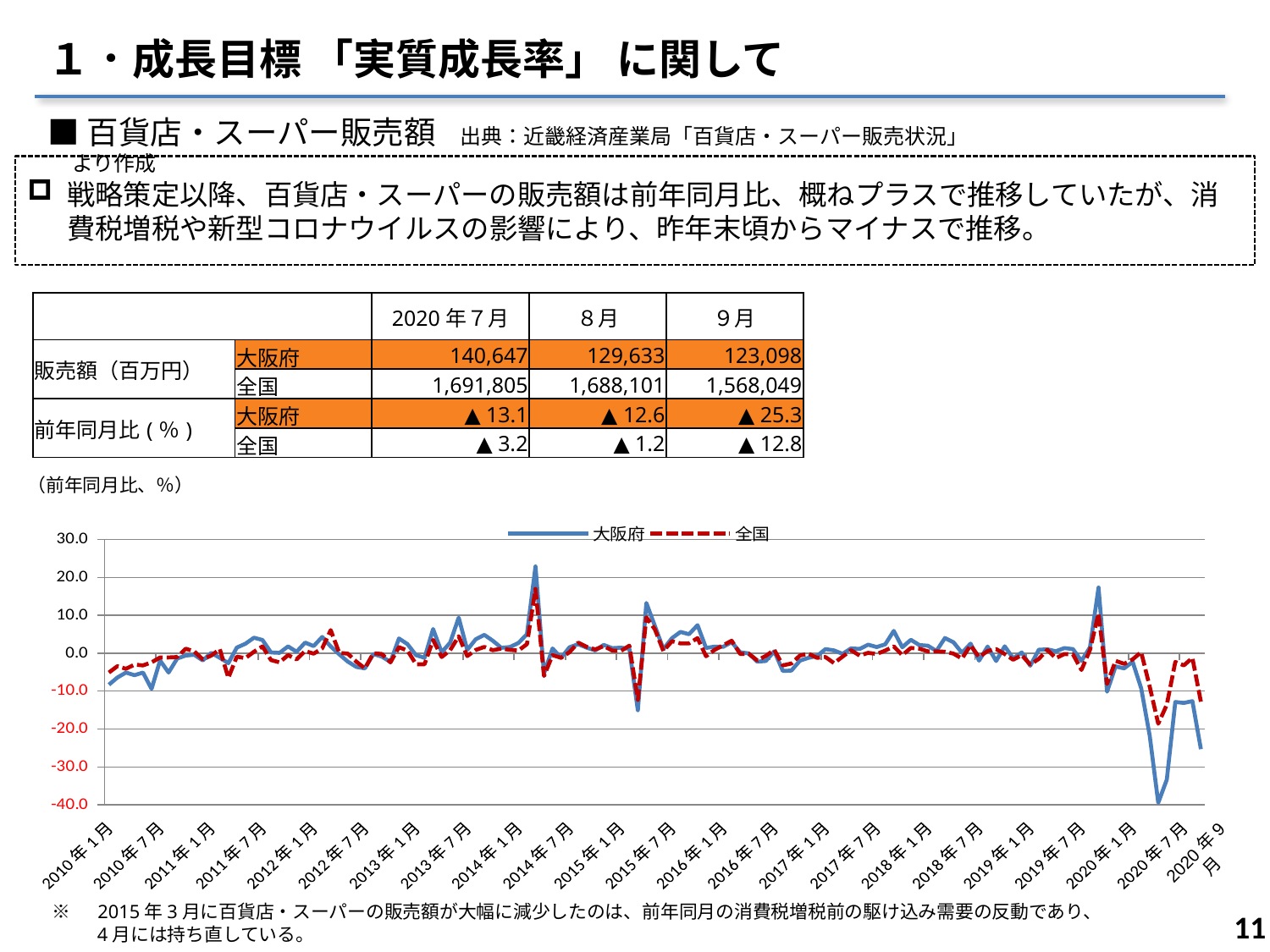
How many date labels are shown along the chart's x axis? 23 Which series reaches the lowest value anywhere on the chart? 大阪府 Is the value for 全国 at 2020年9月 greater or less than -20? greater Do the values for 大阪府 rise or fall between 2020年1月 and the low point in mid-2020? fall What kind of chart is shown on the slide? line chart Which series is drawn as a red dashed line? 全国 Is the value for 大阪府 at 2020年9月 greater or less than -20? less What are the two series named in the chart's legend? 大阪府 and 全国 What are the minimum and maximum values shown on the chart's vertical axis? -40.0 and 30.0 Is the peak value of 大阪府 in early 2014 greater or less than 20? greater How many series does the chart's legend list? 2 At 2020年9月, which series has the higher value, 大阪府 or 全国? 全国